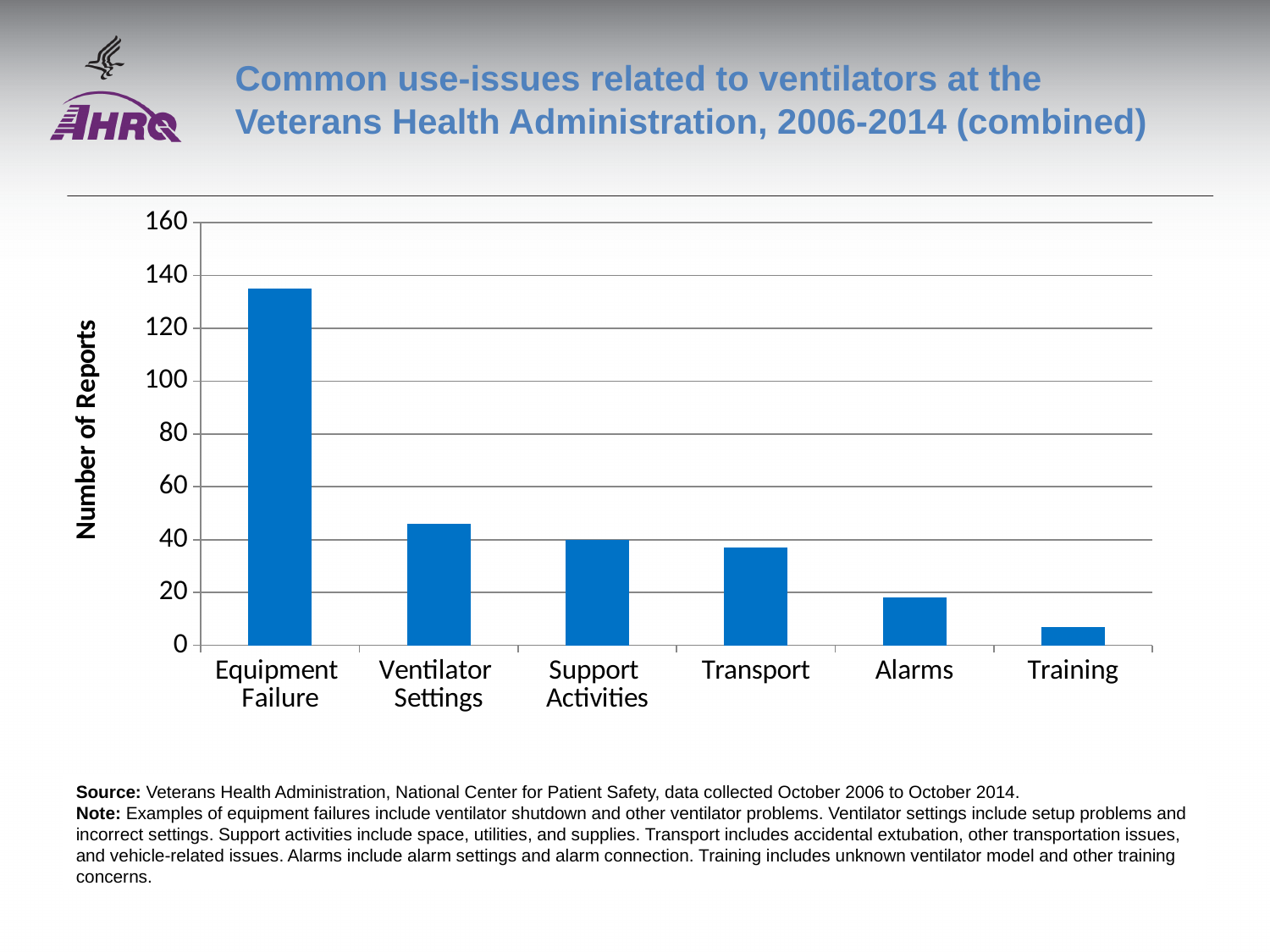
Is the value for Ventilator Settings greater or less than 60? less How many categories are shown on the x axis of the chart? 6 Which category has the lowest number of reports? Training Which category has the highest number of reports? Equipment Failure Is the value for Training greater or less than 20? less Which has more reports, Transport or Training? Transport Which has more reports, Ventilator Settings or Alarms? Ventilator Settings What is the label of the vertical axis? Number of Reports Is the value for Equipment Failure greater or less than 120? greater What kind of chart is shown on the slide? bar chart Do the values rise or fall moving from left to right along the x axis? fall